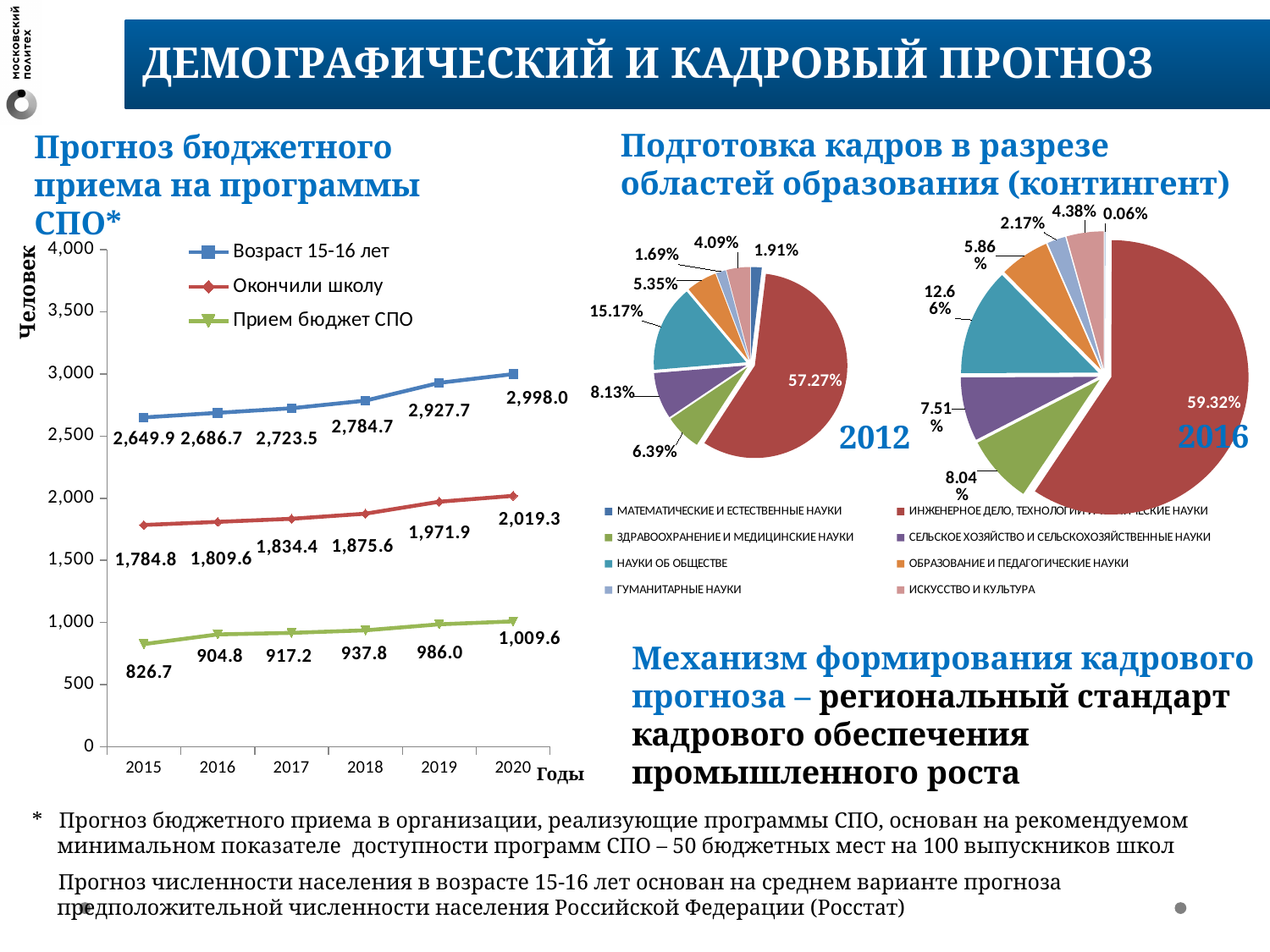
How many series does the legend of the line chart 'Прогноз бюджетного приема на программы СПО' list? 3 In the line chart 'Прогноз бюджетного приема на программы СПО', what is the value for 'Возраст 15-16 лет' in 2020? 2,998.0 In the 2016 pie chart, which category has the smallest share? МАТЕМАТИЧЕСКИЕ И ЕСТЕСТВЕННЫЕ НАУКИ In the line chart 'Прогноз бюджетного приема на программы СПО', what is the value for 'Прием бюджет СПО' in 2015? 826.7 Which is larger: the share of 'НАУКИ ОБ ОБЩЕСТВЕ' in the 2012 pie chart or in the 2016 pie chart? 2012 In the 2012 pie chart, what share does 'ИНЖЕНЕРНОЕ ДЕЛО, ТЕХНОЛОГИИ И ТЕХНИЧЕСКИЕ НАУКИ' have? 57.27% In the 2016 pie chart, what share does 'ИСКУССТВО И КУЛЬТУРА' have? 4.38% In the line chart 'Прогноз бюджетного приема на программы СПО', what is the value for 'Окончили школу' in 2018? 1,875.6 In the line chart 'Прогноз бюджетного приема на программы СПО', what is the difference between the 'Возраст 15-16 лет' value and the 'Окончили школу' value in 2015? 865.1 What kind of chart is 'Прогноз бюджетного приема на программы СПО'? line chart How many years are shown on the x axis of the line chart 'Прогноз бюджетного приема на программы СПО'? 6 In the line chart 'Прогноз бюджетного приема на программы СПО', do the values for 'Прием бюджет СПО' rise or fall from 2015 to 2020? rise